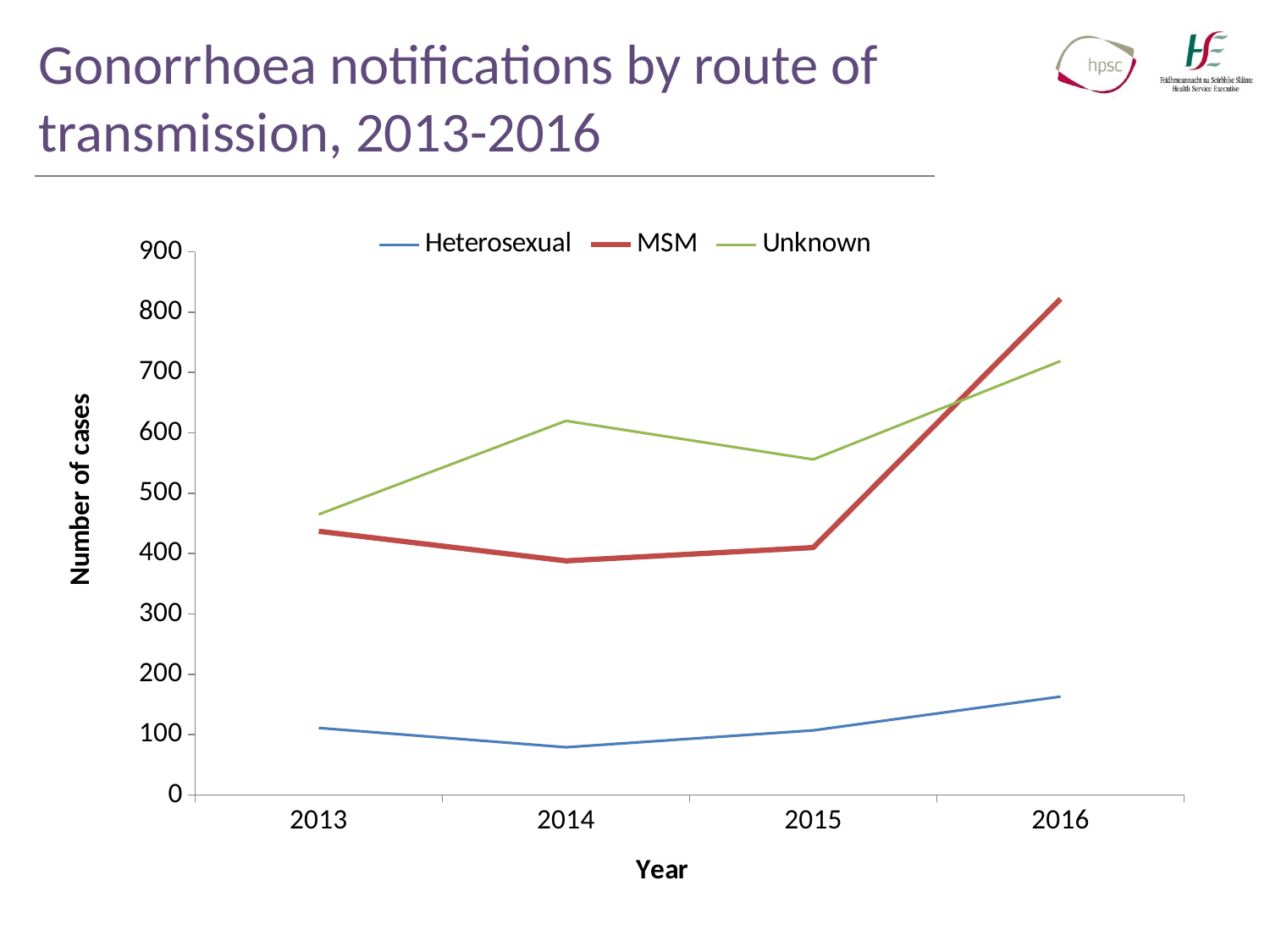
How many years are plotted along the x axis? 4 In which year is the Heterosexual series at its lowest? 2014 How many series does the legend list? 3 Is the value for MSM in 2016 greater or less than 800? greater Is the value for Unknown in 2014 greater or less than 600? greater Does the MSM series rise or fall between 2015 and 2016? rise In which year is the Unknown series at its lowest? 2013 What kind of chart is shown on the slide? line chart Which is larger in 2015, the MSM value or the Unknown value? Unknown Is the value for Heterosexual in 2014 greater or less than 100? less What is the label on the y axis? Number of cases In which year is the MSM series at its highest? 2016